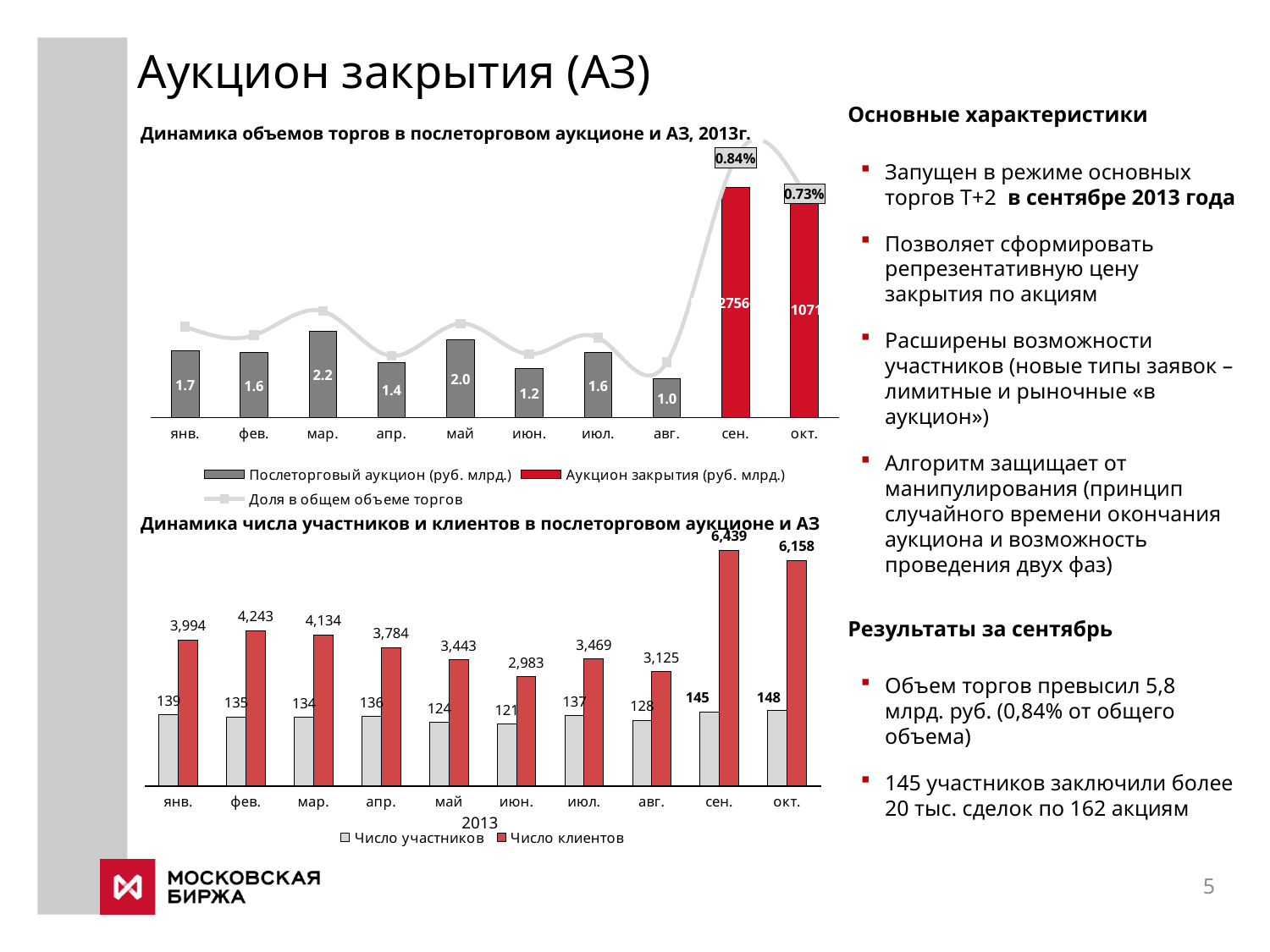
In the top chart, what share of total trading volume (Доля в общем объеме торгов) is shown for сен.? 0.84% In the bottom chart, what is the Число участников value for июн.? 121 In the bottom chart, what is the difference in Число клиентов between сен. and окт.? 281 In the top chart, what share of total trading volume is shown for окт.? 0.73% In the bottom chart (Динамика числа участников и клиентов), what is the Число клиентов value for сен.? 6,439 In the top chart, how many series does the legend list? 3 In the top chart (Динамика объемов торгов в послеторговом аукционе и АЗ, 2013г.), what is the value of the Послеторговый аукцион bar for мар.? 2.2 In the top chart, which month has the lowest Послеторговый аукцион value among янв. to авг.? авг. In the top chart, what is the difference between the Послеторговый аукцион values for мар. and авг.? 1.2 In the bottom chart, which month has the highest Число участников? окт. In the bottom chart, which month has the lowest Число клиентов? июн. In the bottom chart, how many months are shown on the x axis? 10